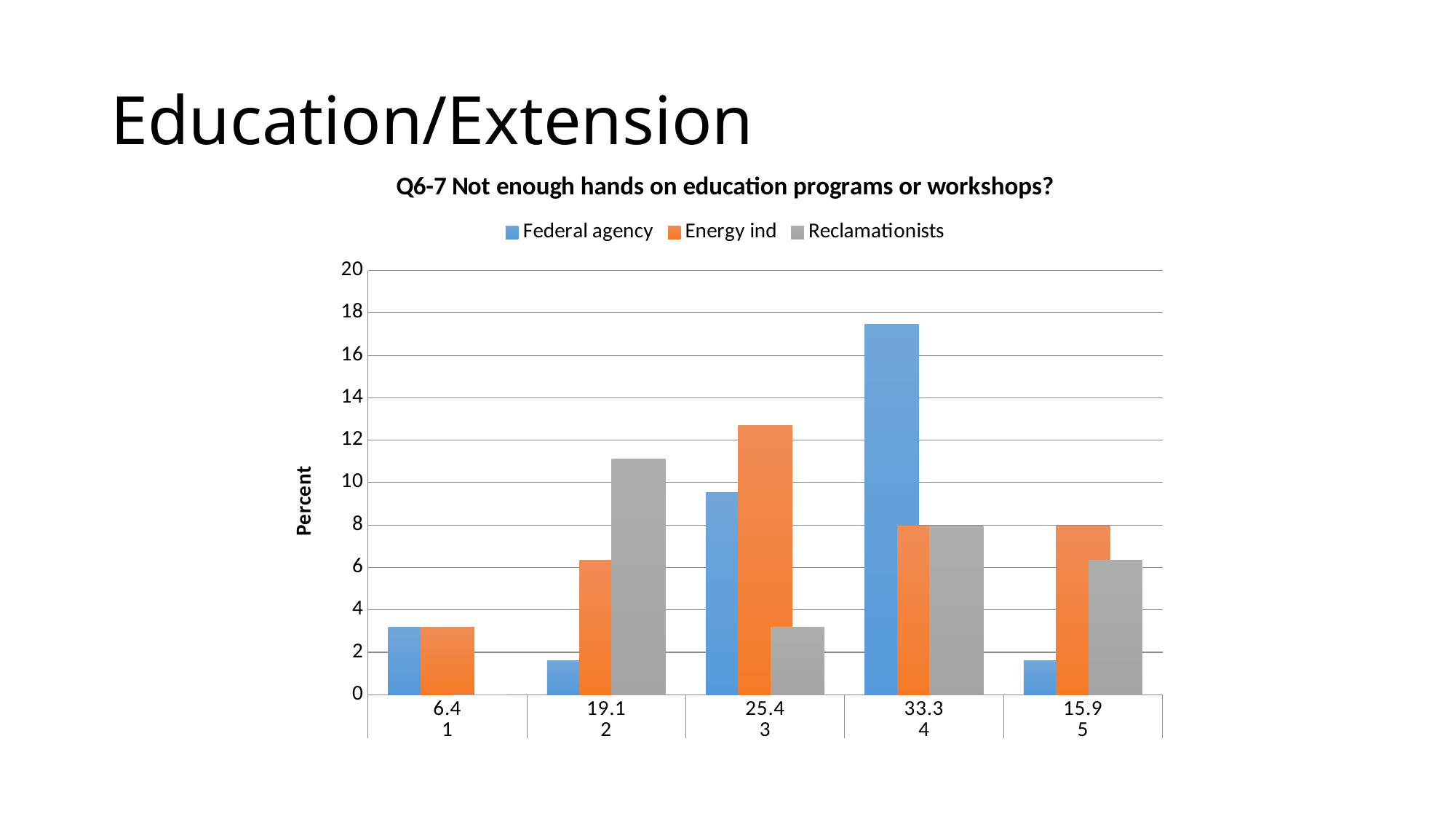
How many categories are shown along the x axis? 5 In category 3, which is larger: the Energy ind bar or the Federal agency bar? Energy ind How many series does the legend list? 3 Which category has the highest Energy ind bar? 3 Is the Energy ind value for category 1 greater or less than 4? less Is the Federal agency value for category 4 greater or less than 16? greater Is the Reclamationists value for category 2 greater or less than 10? greater Which category has the highest Federal agency bar? 4 In category 2, which is larger: the Reclamationists bar or the Energy ind bar? Reclamationists What is the title of the y axis? Percent What kind of chart is shown on the slide? bar chart